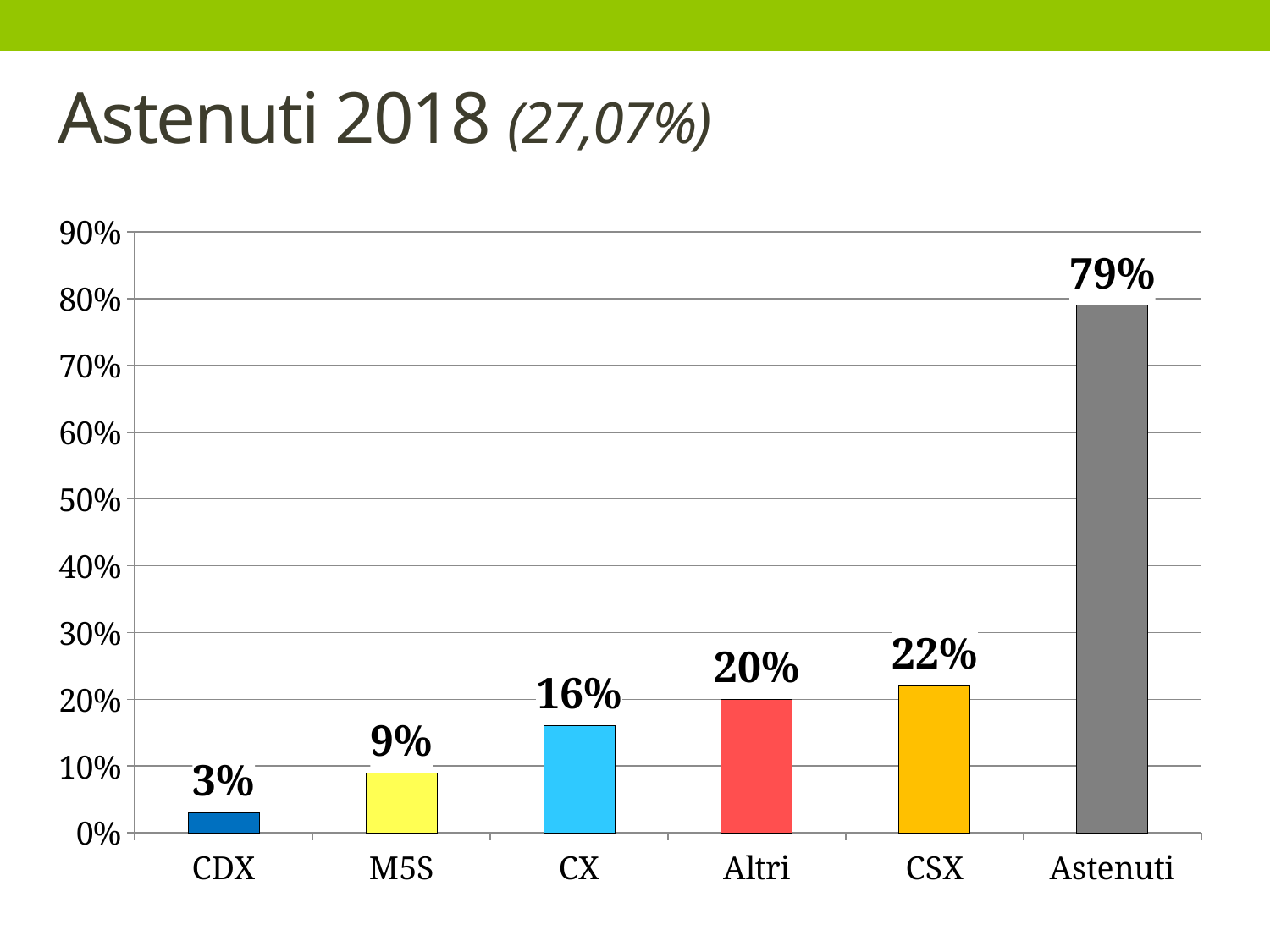
What is the value for CDX? 3% What is the difference between the values for CSX and Altri? 2% Which is larger, the value for M5S or the value for CX? CX What is the difference between the values for Astenuti and CSX? 57% What is the value for Astenuti? 79% Which category has the highest value? Astenuti How many categories are shown on the x axis? 6 What is the title of the slide? Astenuti 2018 (27,07%) Is the value for Altri greater or less than 30%? less What is the value for CX? 16% What kind of chart is shown on the slide? bar chart Which category has the lowest value? CDX